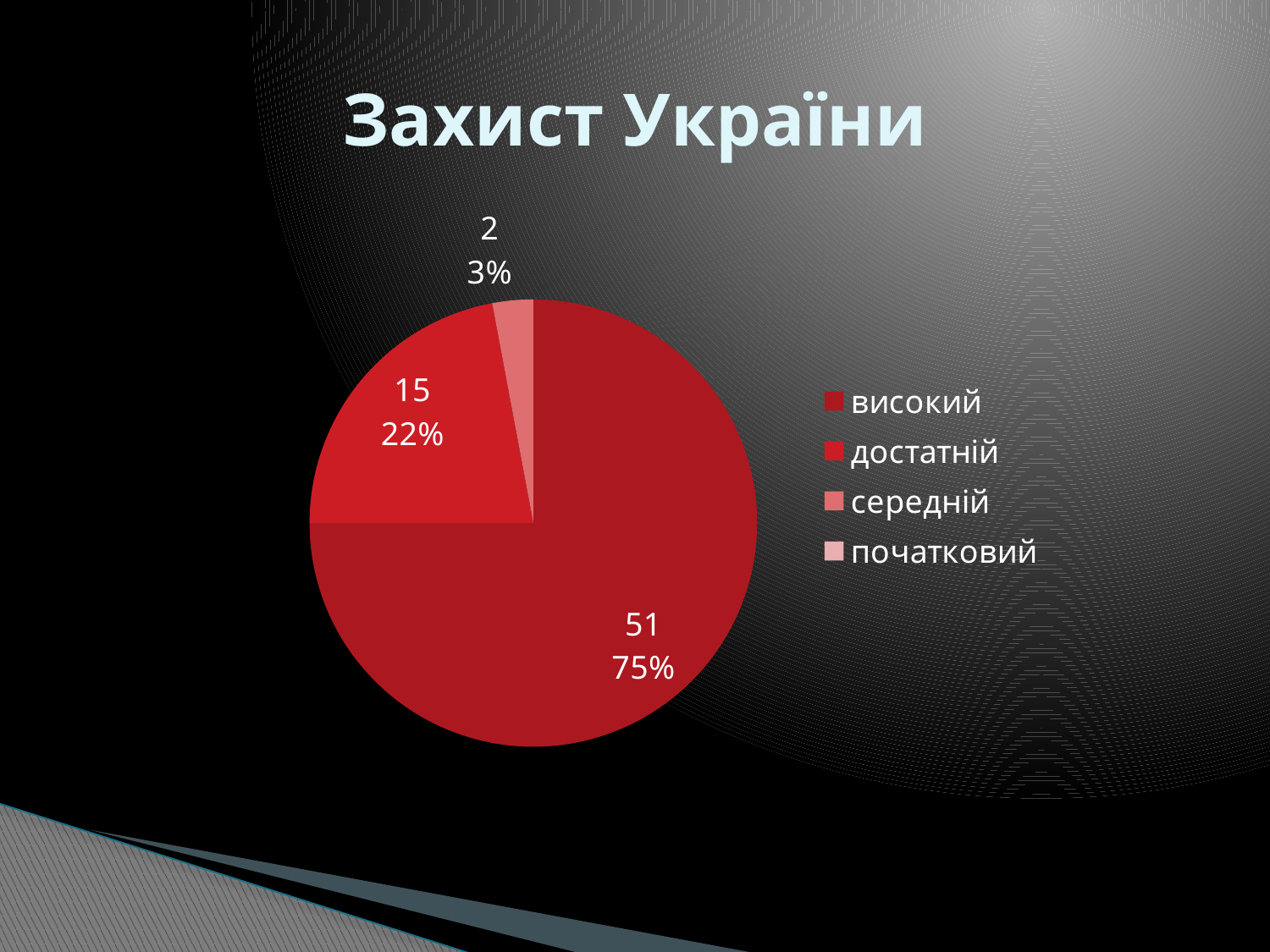
Which is larger, the достатній slice or the середній slice? достатній What is the difference between the високий value and the достатній value? 36 How many entries does the legend list? 4 What percentage share does the достатній slice have? 22% Which category has the largest slice? високий What value is shown for the високий slice? 51 What is the title of the chart? Захист України What kind of chart is shown on the slide? pie chart What value is shown for the достатній slice? 15 What value is shown for the середній slice? 2 What percentage share does the високий slice have? 75% What percentage share does the середній slice have? 3%